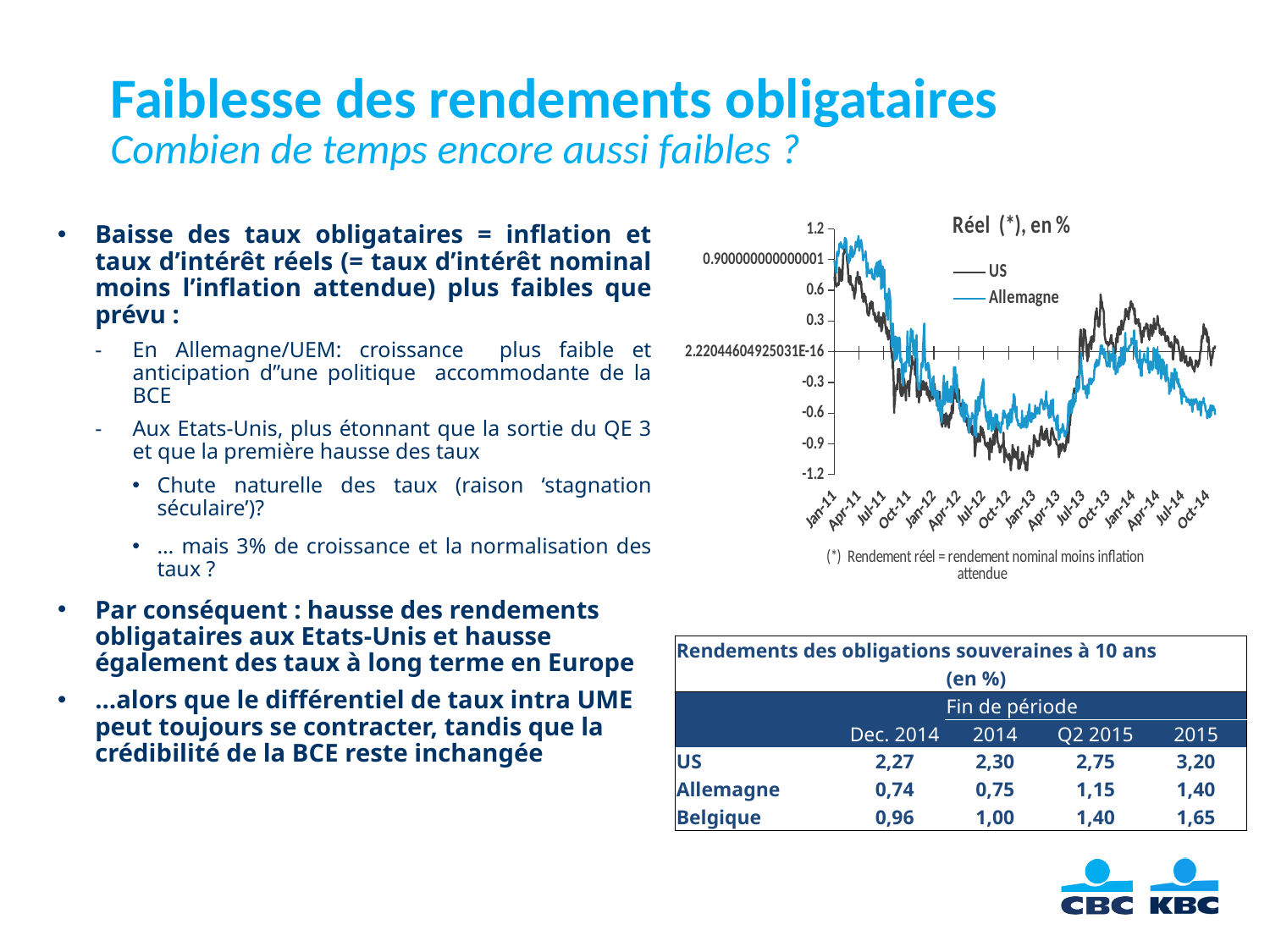
What kind of chart is shown on the slide? line chart Is the value for Allemagne at Oct-14 greater or less than -0.3? less At Oct-14, which series has the higher value, US or Allemagne? US What are the two series named in the chart legend? US and Allemagne At Jan-13, which series has the higher value, US or Allemagne? Allemagne Is the value for US at Jan-11 greater or less than 0.6? greater Is the value for US at Jan-13 greater or less than -0.6? less What is the title of the chart? Réel (*), en % How many series does the legend of the chart list? 2 Which series reaches the lowest point on the chart? US Does the US series rise or fall between Jan-11 and Jan-13? fall